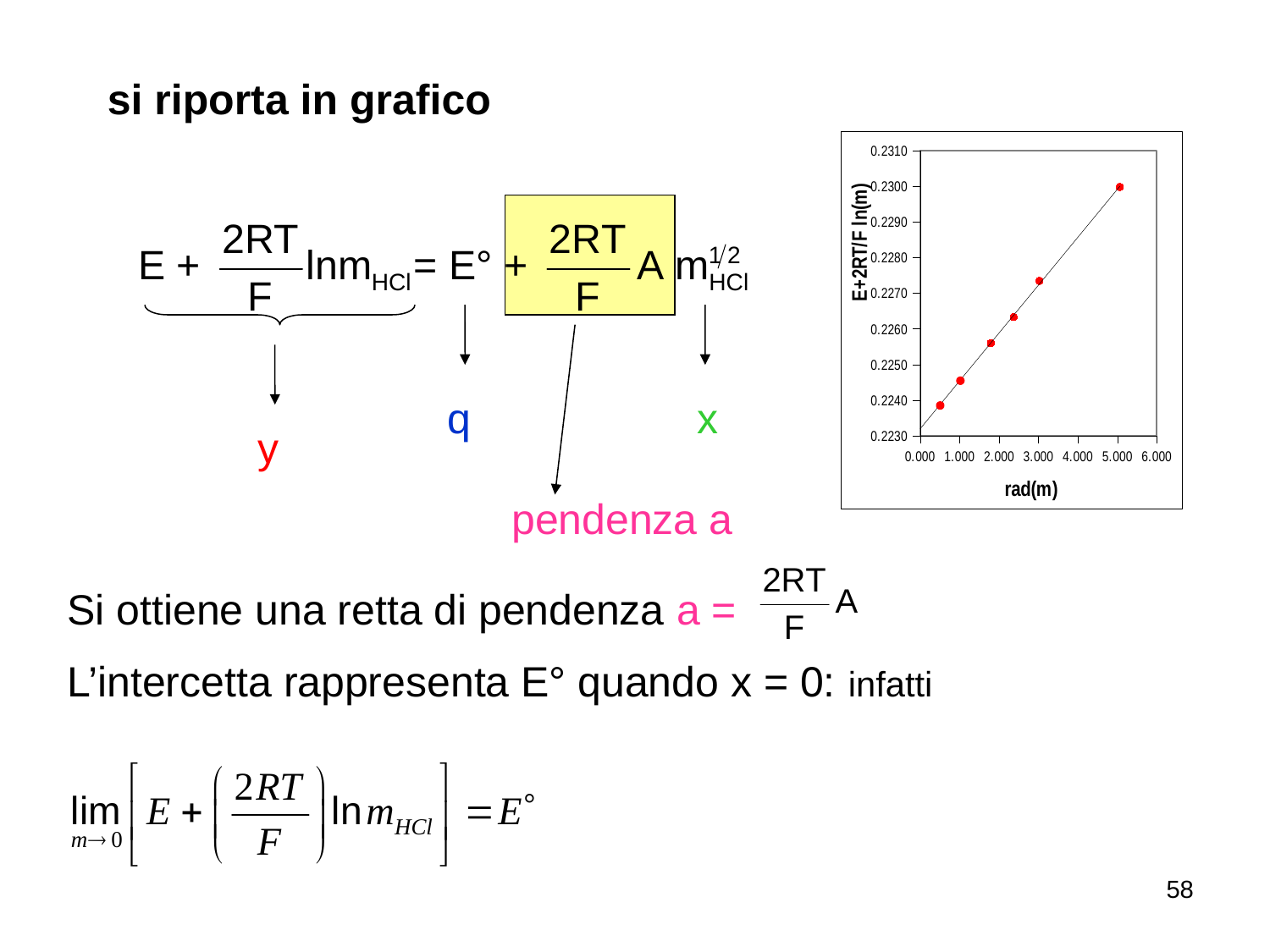
Is the y value of the leftmost data point (near rad(m) = 0.500) greater or less than 0.2250? less How many data points are plotted on the chart? 6 Do the plotted values rise or fall as rad(m) increases? rise What kind of chart is shown on the slide? scatter plot with a fitted line What is the label of the y axis of the chart? E+2RT/F ln(m) What is the label of the x axis of the chart? rad(m) Is the y value of the data point near rad(m) = 3.000 greater or less than 0.2270? greater Is the y value of the rightmost data point (near rad(m) = 5.000) greater or less than 0.2290? greater Which data point has the highest y value: the one near rad(m) = 5.000 or the one near rad(m) = 1.000? the one near rad(m) = 5.000 What is the highest value shown on the y axis of the chart? 0.2310